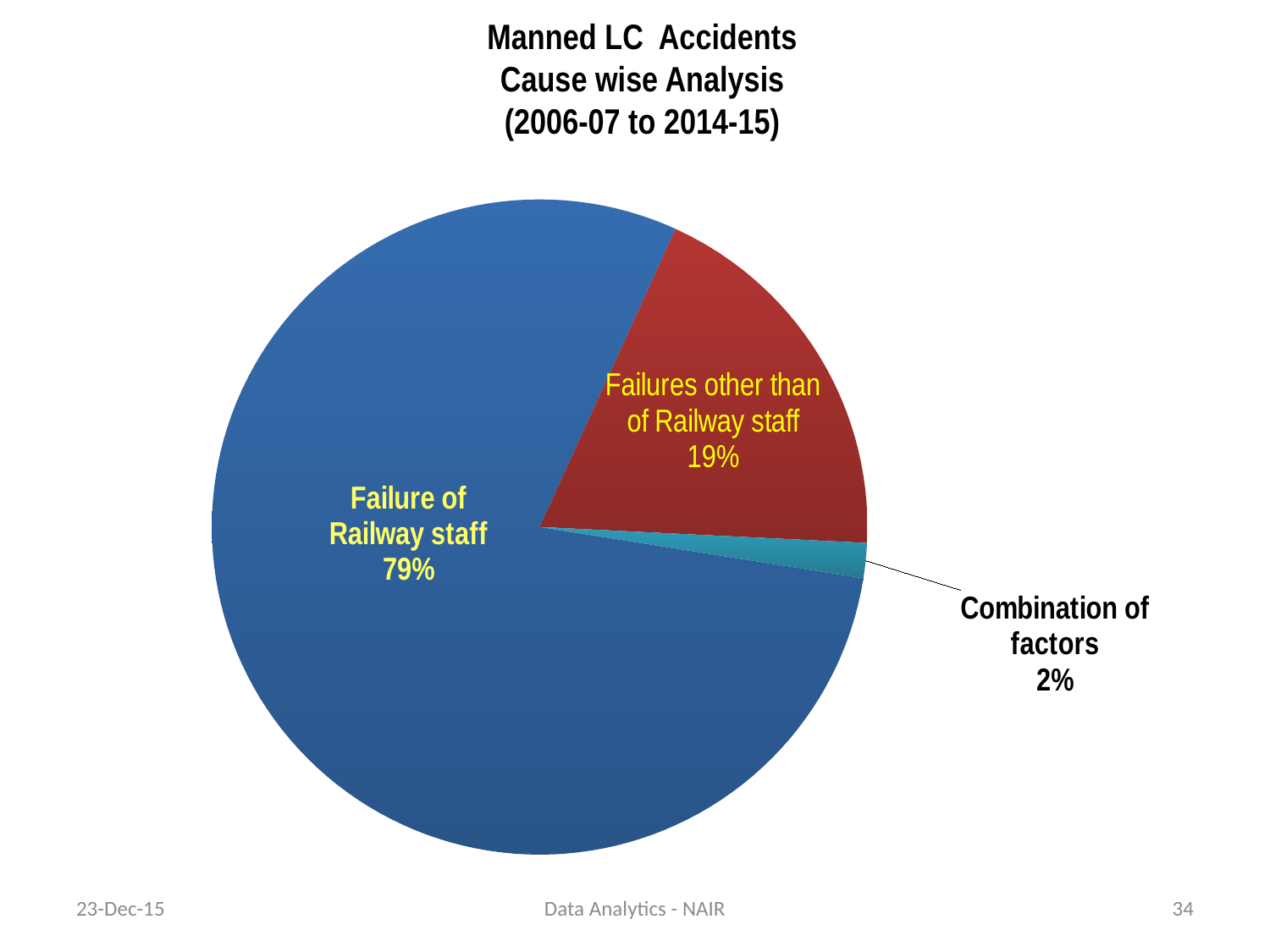
What is the difference in percentage points between the "Failure of Railway staff" slice and the "Failures other than of Railway staff" slice? 60 percentage points What is the title of the chart? Manned LC Accidents Cause wise Analysis (2006-07 to 2014-15) What share of the pie is labelled "Combination of factors"? 2% What is the difference in percentage points between the "Failures other than of Railway staff" slice and the "Combination of factors" slice? 17 percentage points How many slices does the pie chart have? 3 What kind of chart is shown on the slide? Pie chart What share of the pie is labelled "Failures other than of Railway staff"? 19% What colour is the "Failures other than of Railway staff" slice? Red Which category has the smallest slice of the pie? Combination of factors What share of the pie is labelled "Failure of Railway staff"? 79% Which is larger: the "Failures other than of Railway staff" slice or the "Combination of factors" slice? Failures other than of Railway staff Which category has the largest slice of the pie? Failure of Railway staff